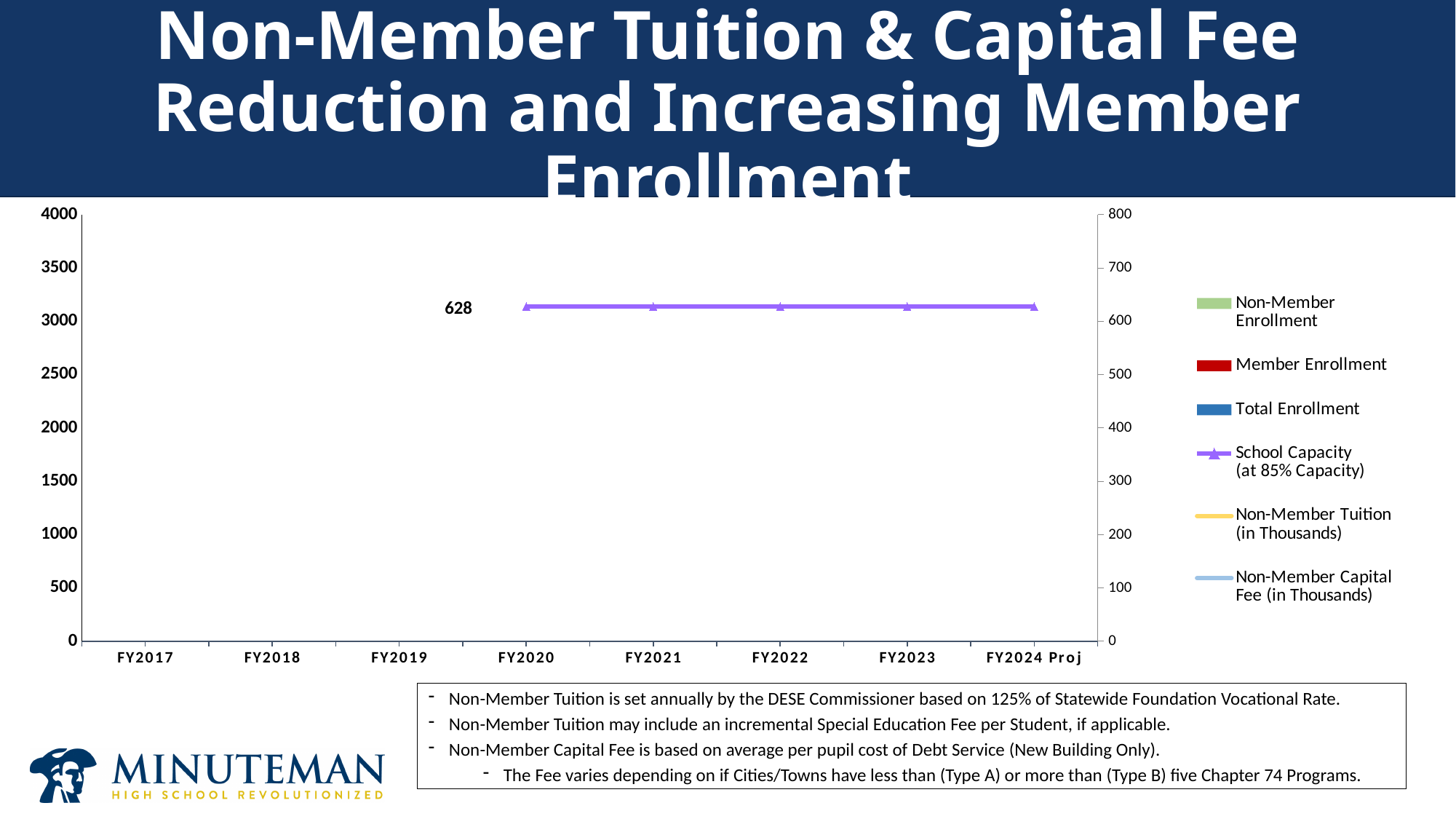
How many fiscal year categories are shown on the x axis? 8 How many data points are plotted on the School Capacity (at 85% Capacity) line? 5 On the right-hand axis, is the School Capacity value at FY2024 Proj greater or less than 700? less What value is printed as the data label on the School Capacity (at 85% Capacity) line? 628 What kind of chart is the School Capacity (at 85% Capacity) series drawn as? line chart Which fiscal year is the first category on the x axis? FY2017 Does the School Capacity (at 85% Capacity) line rise, fall, or stay flat from FY2020 to FY2024 Proj? stays flat Which fiscal year is the last category on the x axis? FY2024 Proj What is the highest tick value shown on the right-hand vertical axis? 800 On the right-hand axis, is the School Capacity value at FY2022 greater or less than 600? greater What colour is the School Capacity (at 85% Capacity) line in the legend? purple How many series does the legend list? 6